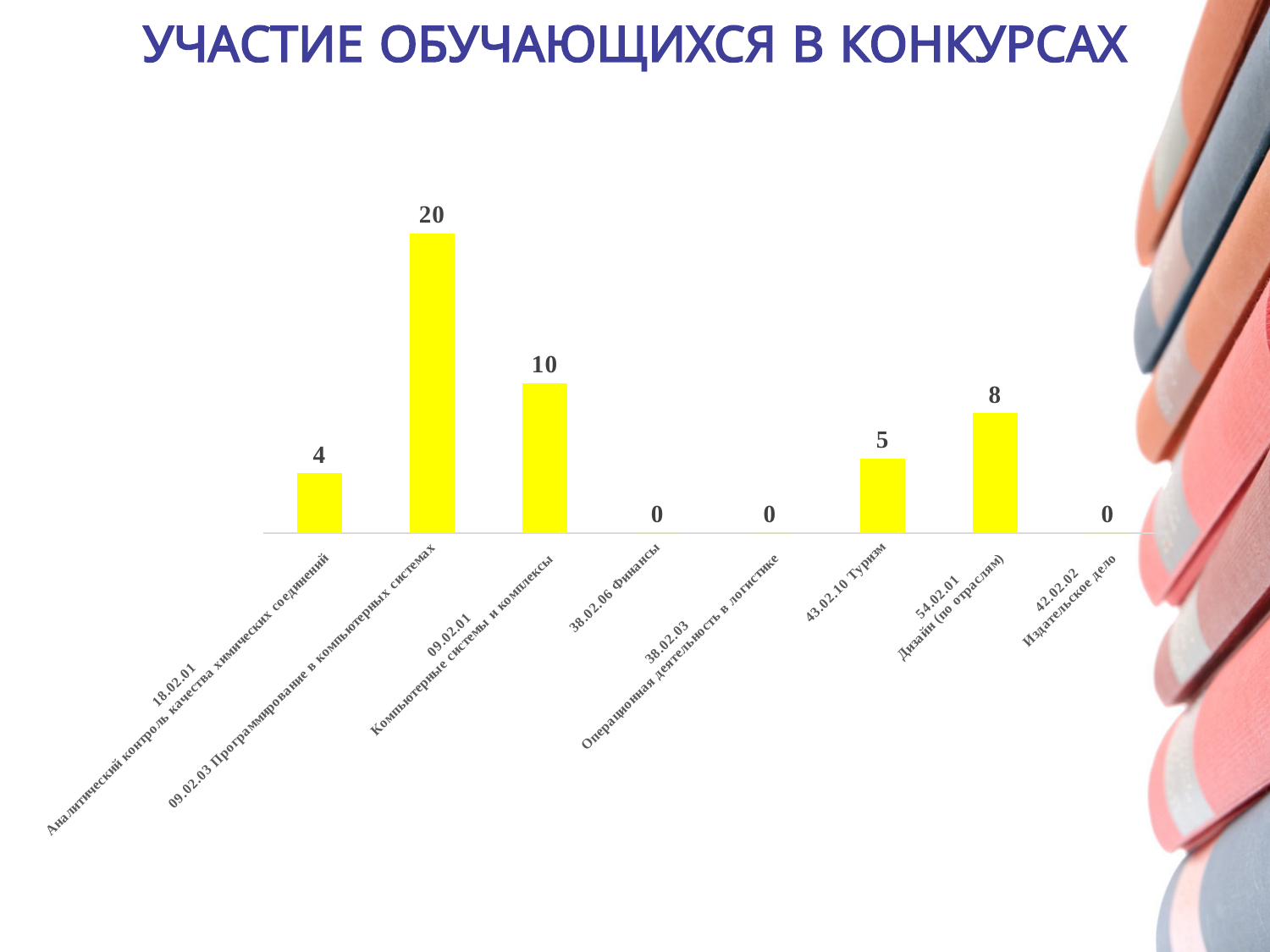
What kind of chart is shown on the slide? Bar chart What is the value for 54.02.01 Дизайн (по отраслям)? 8 What is the value for 43.02.10 Туризм? 5 What is the title of the slide? УЧАСТИЕ ОБУЧАЮЩИХСЯ В КОНКУРСАХ Which category has the highest value? 09.02.03 Программирование в компьютерных системах Which is larger, the value for 54.02.01 Дизайн (по отраслям) or the value for 43.02.10 Туризм? 54.02.01 Дизайн (по отраслям) What is the value for 09.02.03 Программирование в компьютерных системах? 20 What is the value for 18.02.01 Аналитический контроль качества химических соединений? 4 What is the difference between the values for 09.02.03 Программирование в компьютерных системах and 09.02.01 Компьютерные системы и комплексы? 10 What is the value for 38.02.06 Финансы? 0 How many categories have a value of 0? 3 How many categories are shown on the x axis? 8